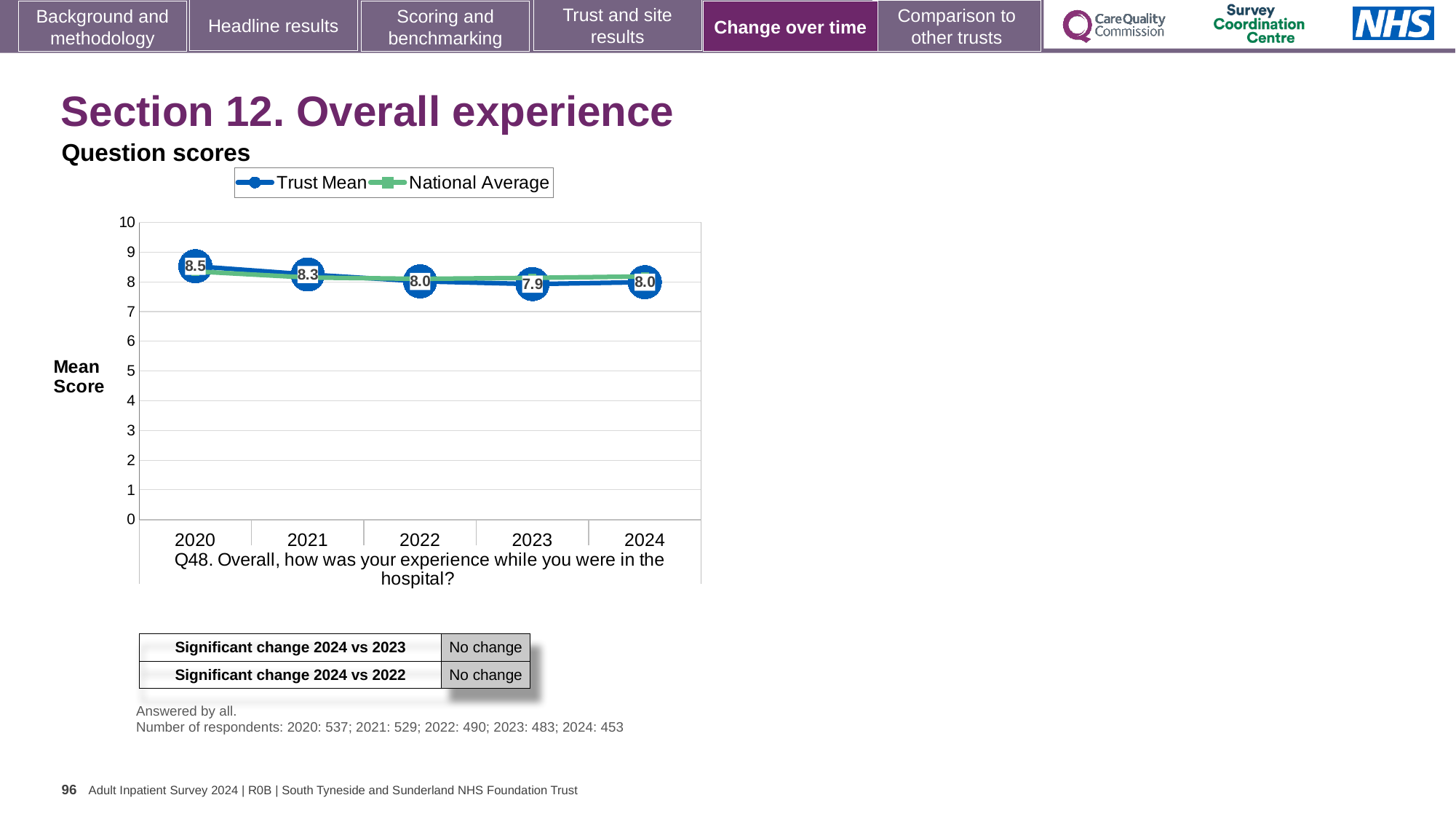
How many series does the legend list? 2 How many years are plotted on the x axis? 5 What kind of chart is shown? Line chart Is the National Average value for 2022 greater or less than 5? greater In which year is the Trust Mean lowest? 2023 What is the Trust Mean score for 2024? 8.0 Which is larger, the Trust Mean in 2021 or in 2023? 2021 Does the Trust Mean rise or fall from 2020 to 2023? Fall What is the Trust Mean score for 2020? 8.5 What is the difference between the Trust Mean in 2020 and in 2024? 0.5 In which year is the Trust Mean highest? 2020 What is the Trust Mean score for 2023? 7.9